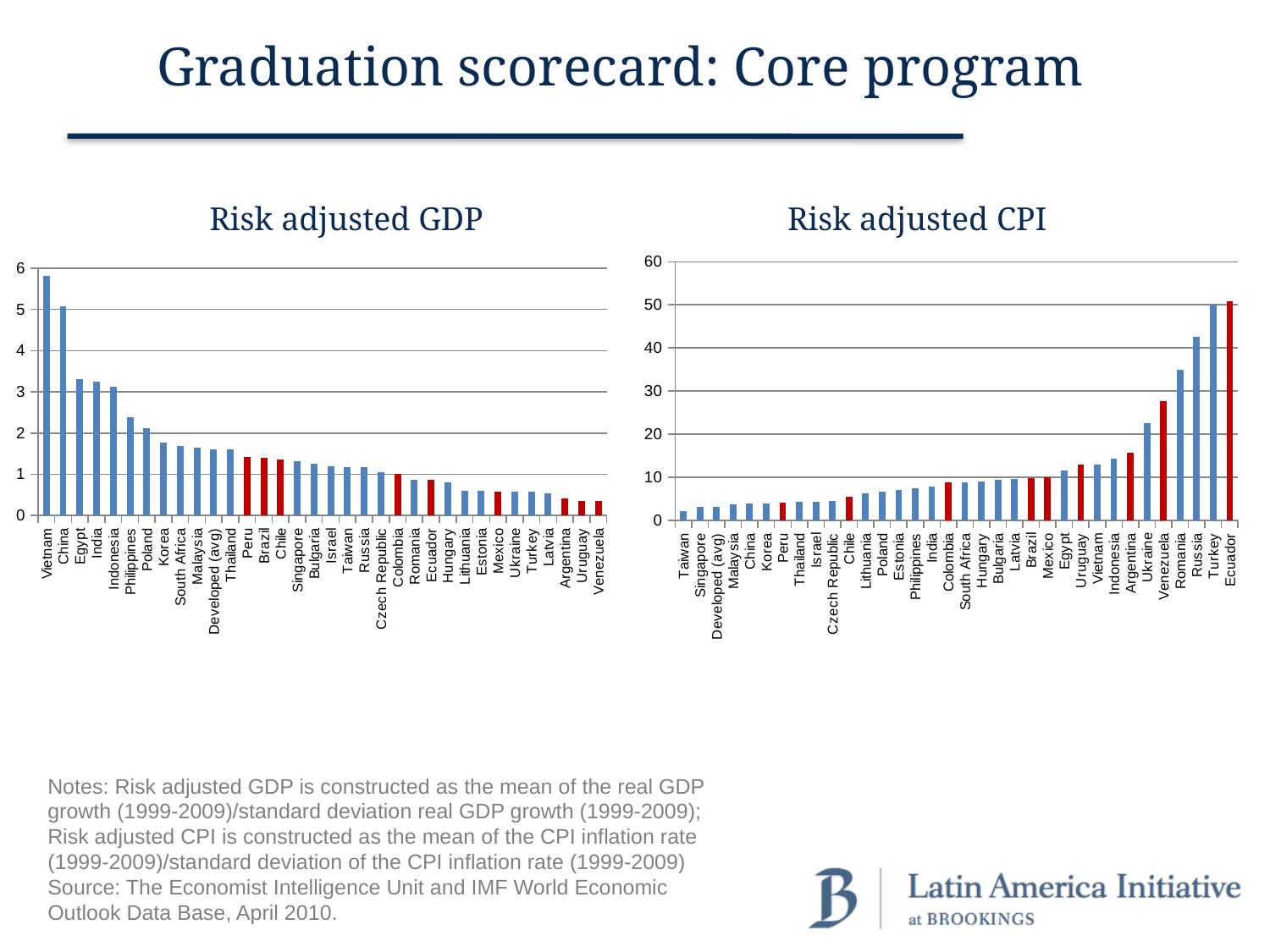
In the Risk adjusted CPI chart, is the value for Russia greater or less than 40? greater In the Risk adjusted CPI chart, do the values rise or fall from left to right along the x axis? rise In the Risk adjusted GDP chart, is the value for Egypt greater or less than 3? greater How many countries/categories are plotted in the Risk adjusted GDP chart? 34 What is the title of the chart on the right side of the slide? Risk adjusted CPI In the Risk adjusted GDP chart, is the value for Vietnam greater or less than 5? greater In the Risk adjusted GDP chart, which is larger, the value for Vietnam or the value for China? Vietnam In the Risk adjusted CPI chart, which is larger, the value for Romania or the value for Ukraine? Romania What kind of chart is the Risk adjusted GDP chart? Bar chart In the Risk adjusted GDP chart, which country has the highest value? Vietnam In the Risk adjusted GDP chart, do the values rise or fall from left to right along the x axis? fall